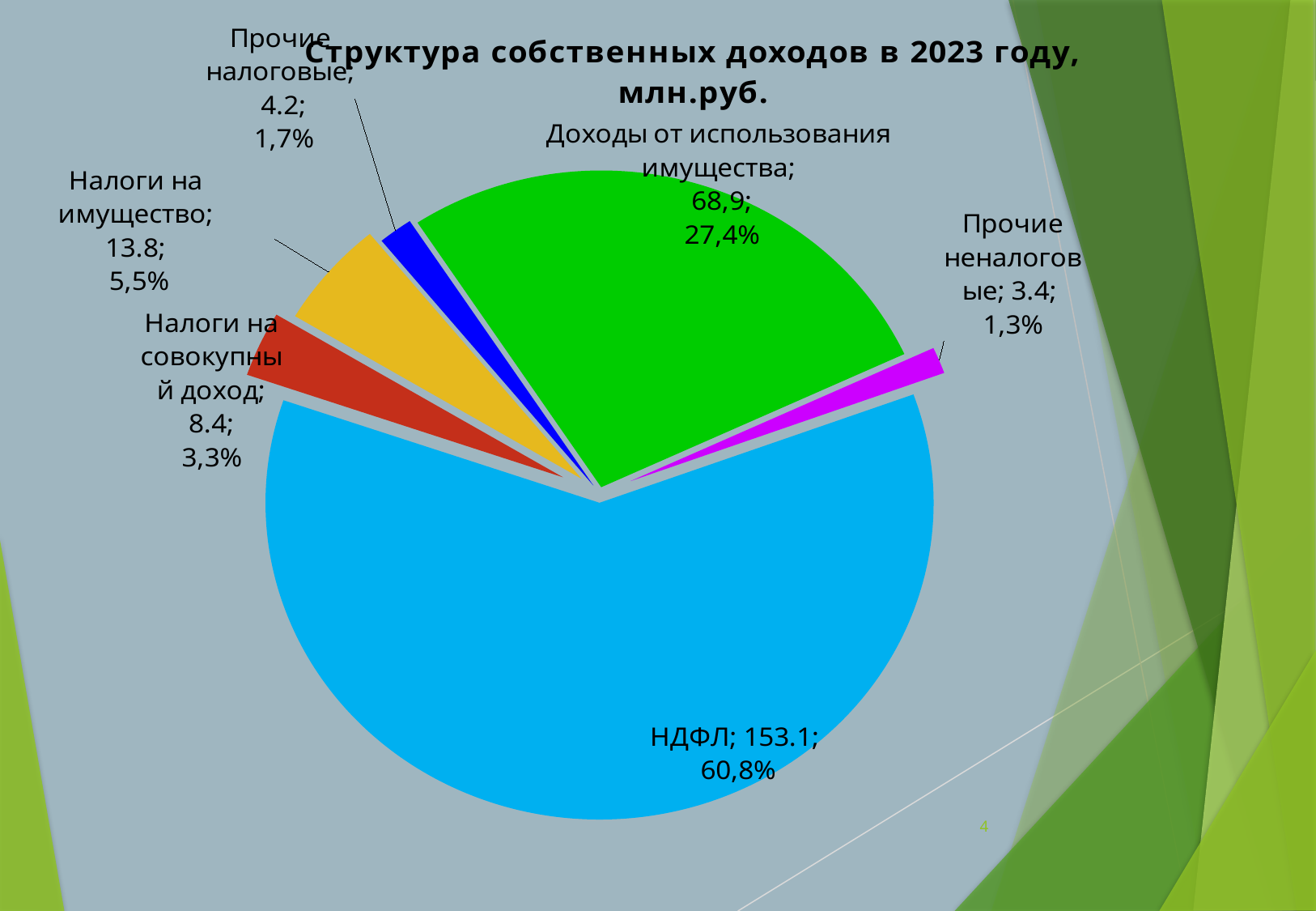
How many slices does the pie chart have? 6 What is the value for НДФЛ? 153.1 Which category has the smallest slice? Прочие неналоговые What is the difference between the values for НДФЛ and Доходы от использования имущества? 84.2 What share of the pie does Налоги на совокупный доход represent? 3,3% What share of the pie does Прочие неналоговые represent? 1,3% What is the value for Налоги на имущество? 13.8 Which is larger, Налоги на имущество or Прочие налоговые? Налоги на имущество Which category has the largest slice? НДФЛ What is the value for Доходы от использования имущества? 68,9 What type of chart is shown on the slide? pie chart What is the title of the chart? Структура собственных доходов в 2023 году, млн.руб.